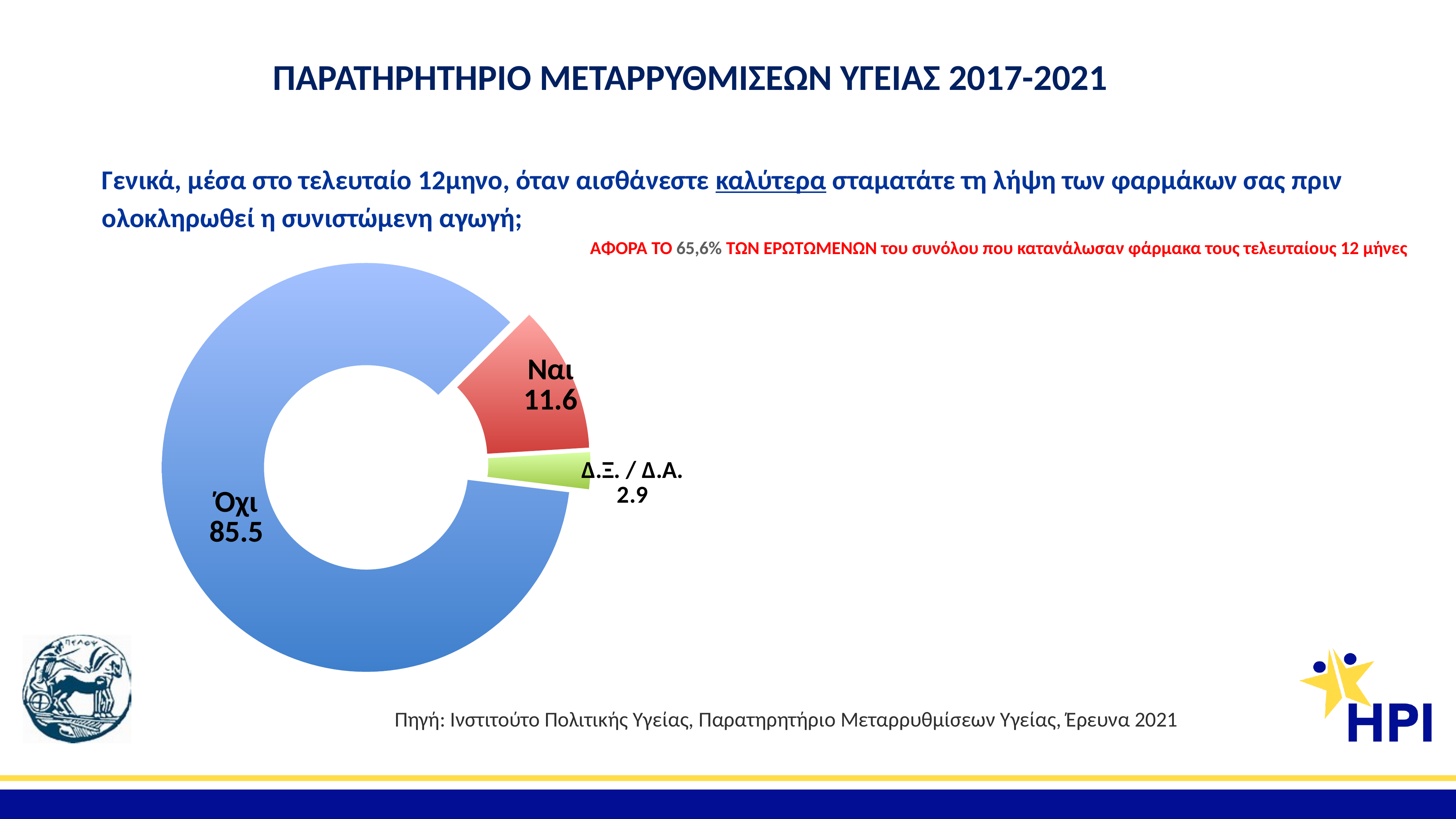
What colour is the 'Όχι' slice? Blue Which category has the largest slice? Όχι What value is shown for the 'Ναι' slice? 11.6 What colour is the 'Ναι' slice? Red What kind of chart is shown on the slide? Doughnut (pie) chart Which category has the smallest slice? Δ.Ξ. / Δ.Α. What is the difference between the values for 'Ναι' and 'Δ.Ξ. / Δ.Α.'? 8.7 What is the difference between the values for 'Όχι' and 'Ναι'? 73.9 Which is larger, the value for 'Ναι' or the value for 'Δ.Ξ. / Δ.Α.'? Ναι What value is shown for the 'Δ.Ξ. / Δ.Α.' slice? 2.9 How many slices does the chart have? 3 What value is shown for the 'Όχι' slice? 85.5